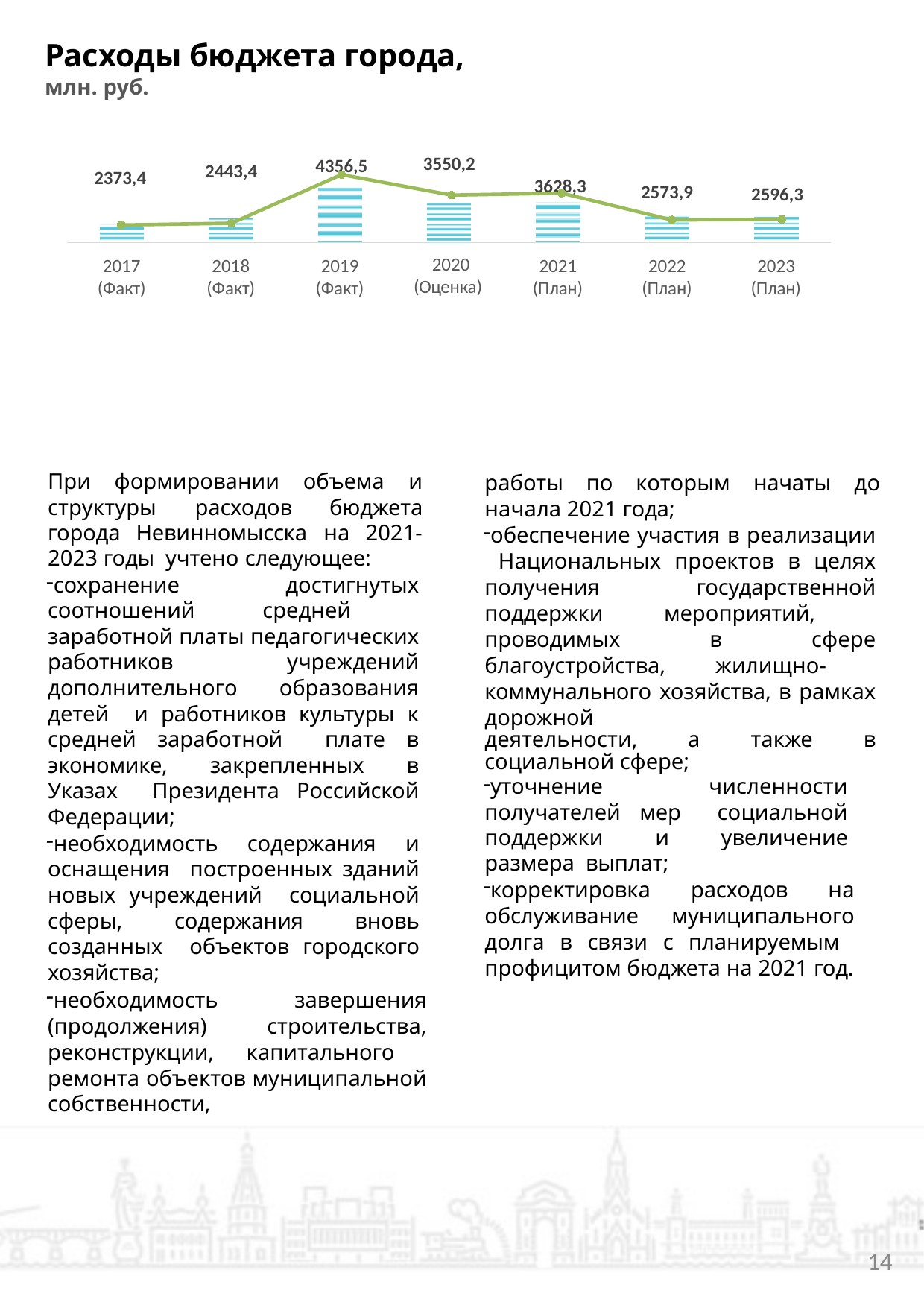
What is the difference between the values for 2023 (План) and 2022 (План)? 22,4 Which year has the highest value? 2019 (Факт) What is the value for 2019 (Факт)? 4356,5 What is the value for 2017 (Факт)? 2373,4 What unit is given in the chart title? млн. руб. What is the difference between the values for 2019 (Факт) and 2018 (Факт)? 1913,1 How many years are shown on the x axis? 7 Which year has the lowest value? 2017 (Факт) What is the value for 2020 (Оценка)? 3550,2 Do the values rise or fall from 2021 (План) to 2022 (План)? fall What is the value for 2023 (План)? 2596,3 Which is larger, the value for 2021 (План) or the value for 2022 (План)? 2021 (План)